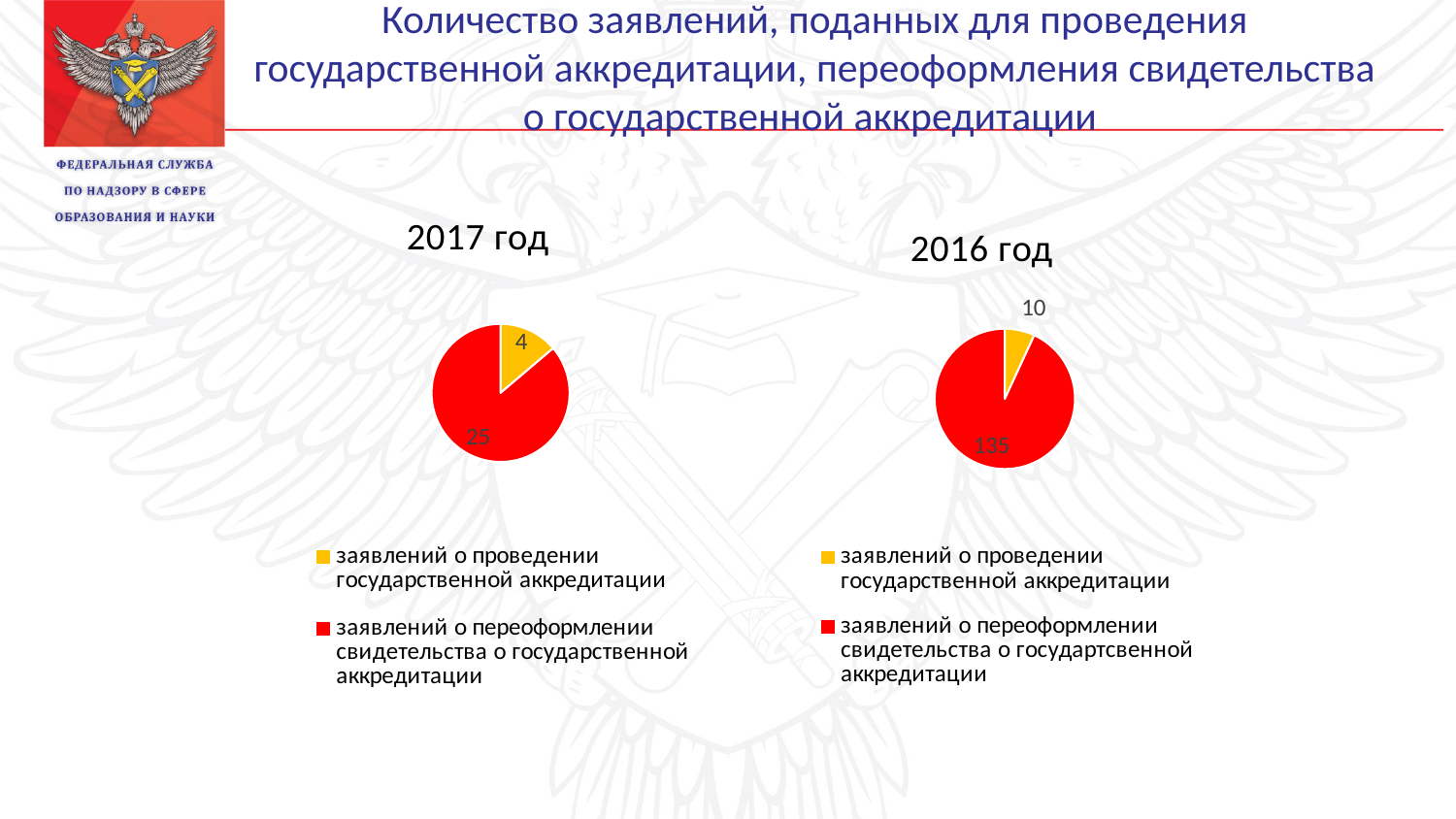
In the 2016 год chart, which category has the largest slice? заявлений о переоформлении свидетельства о государственной аккредитации Which is larger: the value for заявлений о проведении государственной аккредитации in 2016 год or in 2017 год? 2016 год In the 2017 год chart, what is the value for заявлений о переоформлении свидетельства о государственной аккредитации? 25 In the 2017 год chart, what is the difference between the two slice values? 21 In the 2017 год chart, what is the value for заявлений о проведении государственной аккредитации? 4 In the 2016 год chart, what is the value for заявлений о проведении государственной аккредитации? 10 In the 2017 год chart, what colour is the slice for заявлений о переоформлении свидетельства о государственной аккредитации? red In the 2016 год chart, what is the value for заявлений о переоформлении свидетельства о государственной аккредитации? 135 In the 2017 год chart, which category has the smallest slice? заявлений о проведении государственной аккредитации How many slices does the 2016 год pie chart have? 2 In the 2016 год chart, what is the difference between the two slice values? 125 What kind of chart is used for the 2017 год data? pie chart